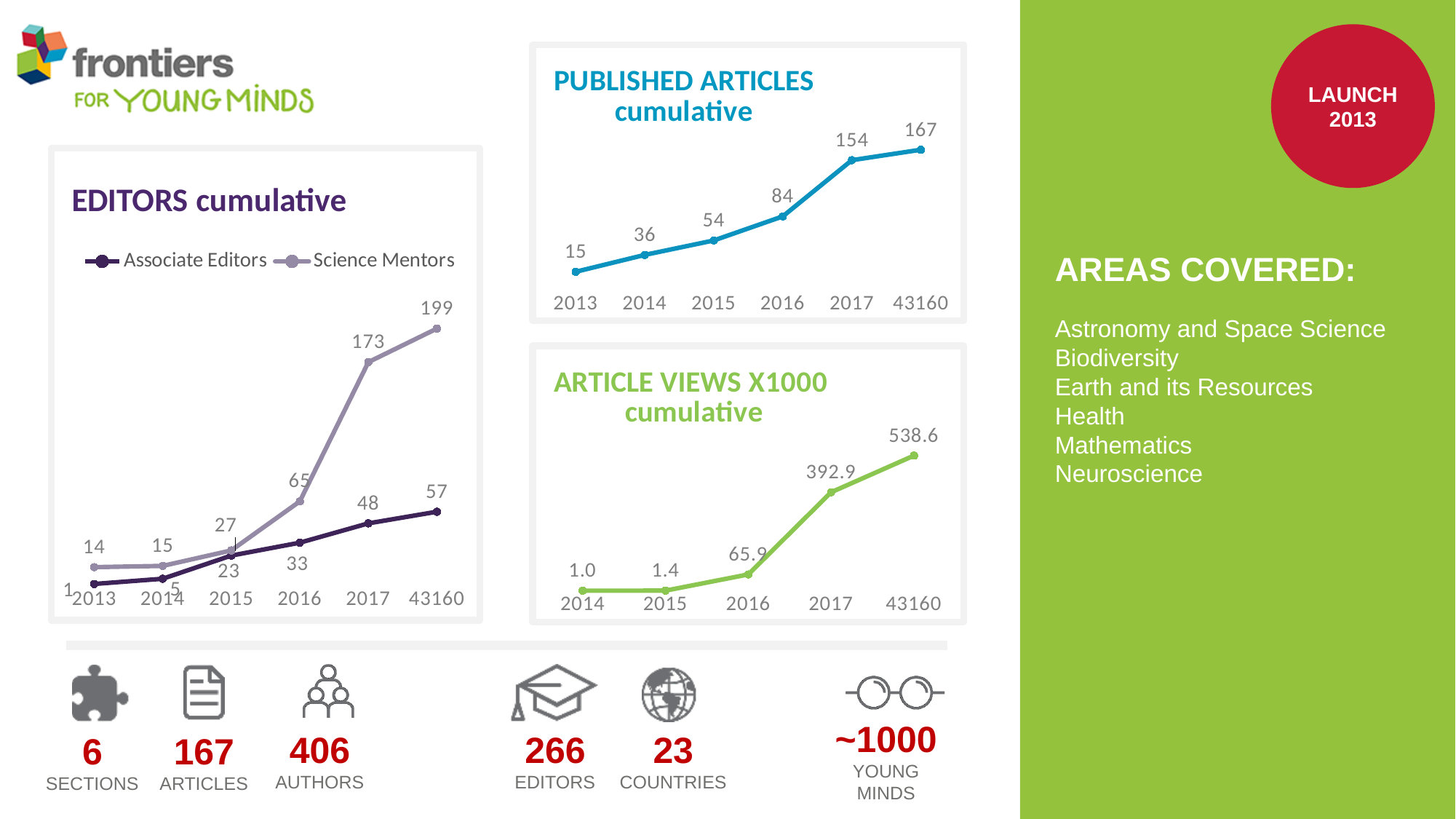
In the ARTICLE VIEWS X1000 cumulative chart, what is the value for 2017? 392.9 In the EDITORS cumulative chart, how many series does the legend list? 2 In the EDITORS cumulative chart, what is the Associate Editors value for 2016? 33 In the ARTICLE VIEWS X1000 cumulative chart, do the values rise or fall from 2014 to the last point? rise What kind of chart is the PUBLISHED ARTICLES cumulative chart? line chart In the ARTICLE VIEWS X1000 cumulative chart, how many data points are plotted? 5 In the ARTICLE VIEWS X1000 cumulative chart, which year has the lowest value? 2014 In the EDITORS cumulative chart, which series has the higher value at the last point on the x axis? Science Mentors In the PUBLISHED ARTICLES cumulative chart, what is the value for 2013? 15 In the PUBLISHED ARTICLES cumulative chart, what is the value for 2016? 84 In the EDITORS cumulative chart, what is the Science Mentors value for 2017? 173 In the PUBLISHED ARTICLES cumulative chart, what is the difference between the 2017 value and the 2016 value? 70